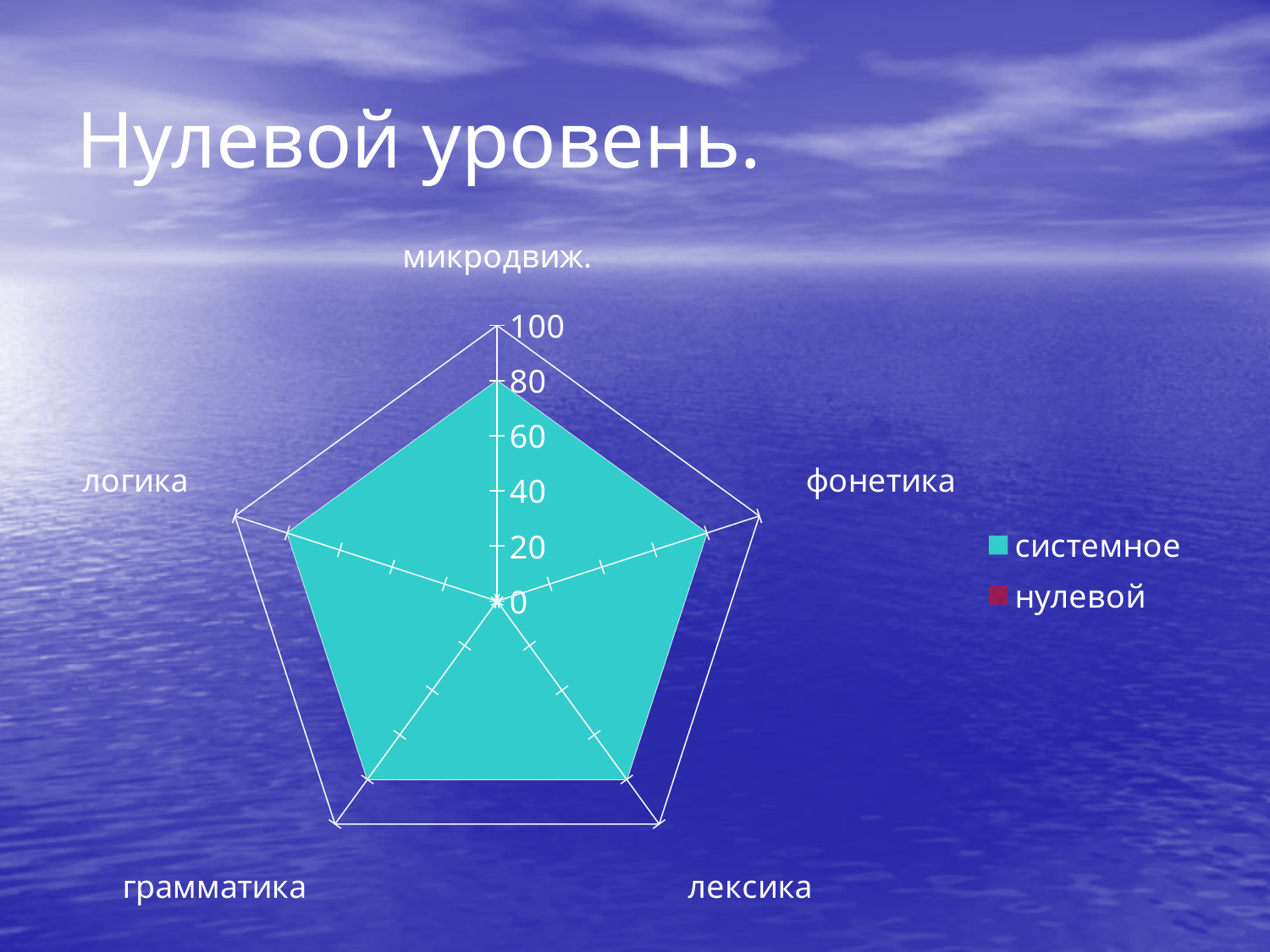
Is the value of the системное series for логика greater or less than 100? less Is the value of the системное series for грамматика greater or less than 40? greater What kind of chart is shown on the slide? radar chart Is the value of the системное series for фонетика greater or less than 60? greater What is the title of the slide containing the chart? Нулевой уровень. What are the two series names listed in the legend? системное, нулевой How many series does the legend list? 2 How many categories (axes) does the radar chart have? 5 What is the value of the системное series for микродвиж.? 80